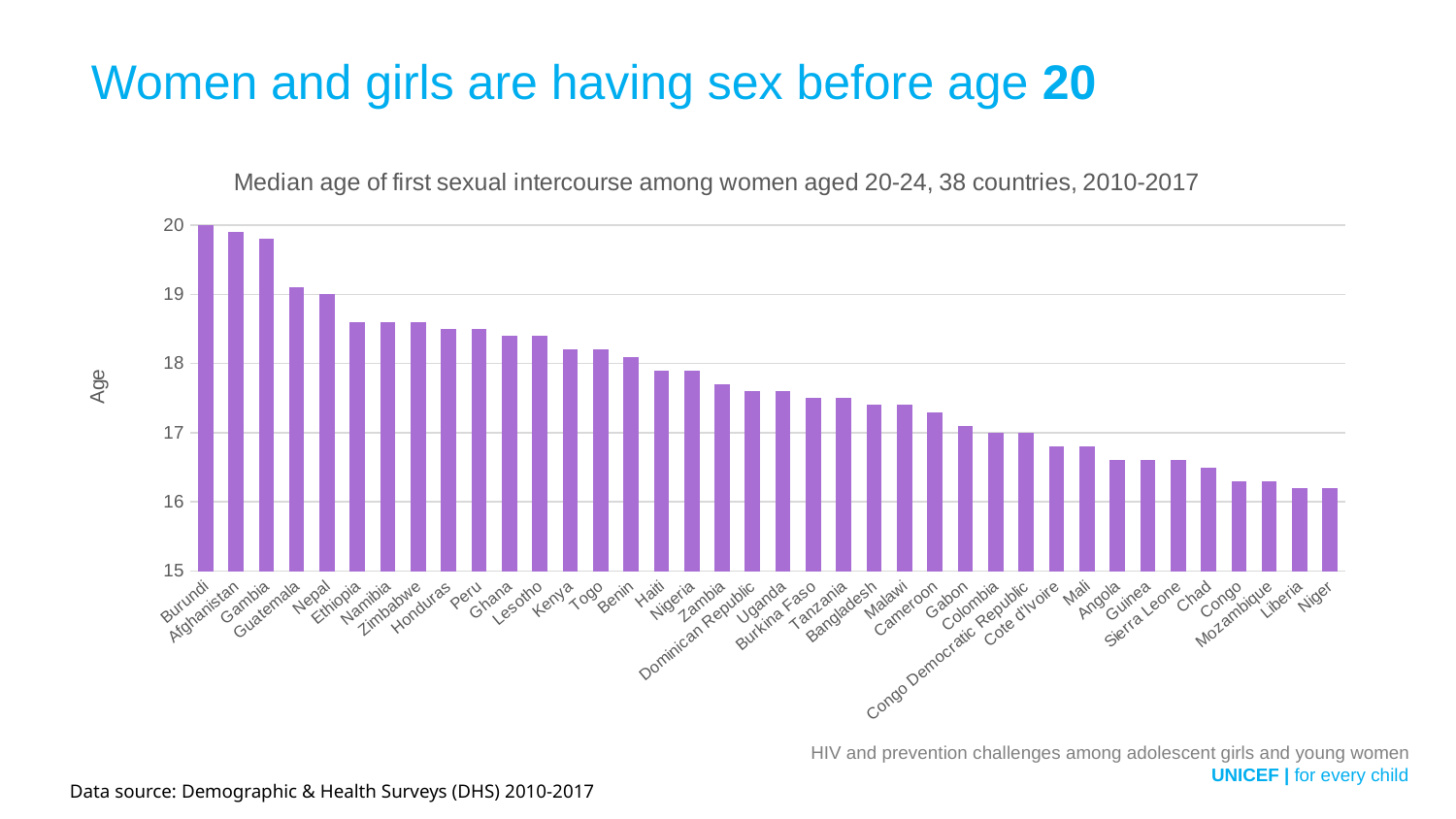
Is the value for Malawi greater or less than 17? greater What is the median age of first sexual intercourse for Burundi? 20 What is the label on the vertical axis of the chart? Age Do the values rise or fall moving from left to right along the x axis? fall Is the value for Niger greater or less than 17? less Is the value for Kenya greater or less than 18? greater Which has a higher median age of first sexual intercourse, Gambia or Nepal? Gambia How many countries are shown in the chart? 38 Which country has the highest median age of first sexual intercourse? Burundi What kind of chart is shown on the slide? bar chart What is the median age of first sexual intercourse for Nepal? 19